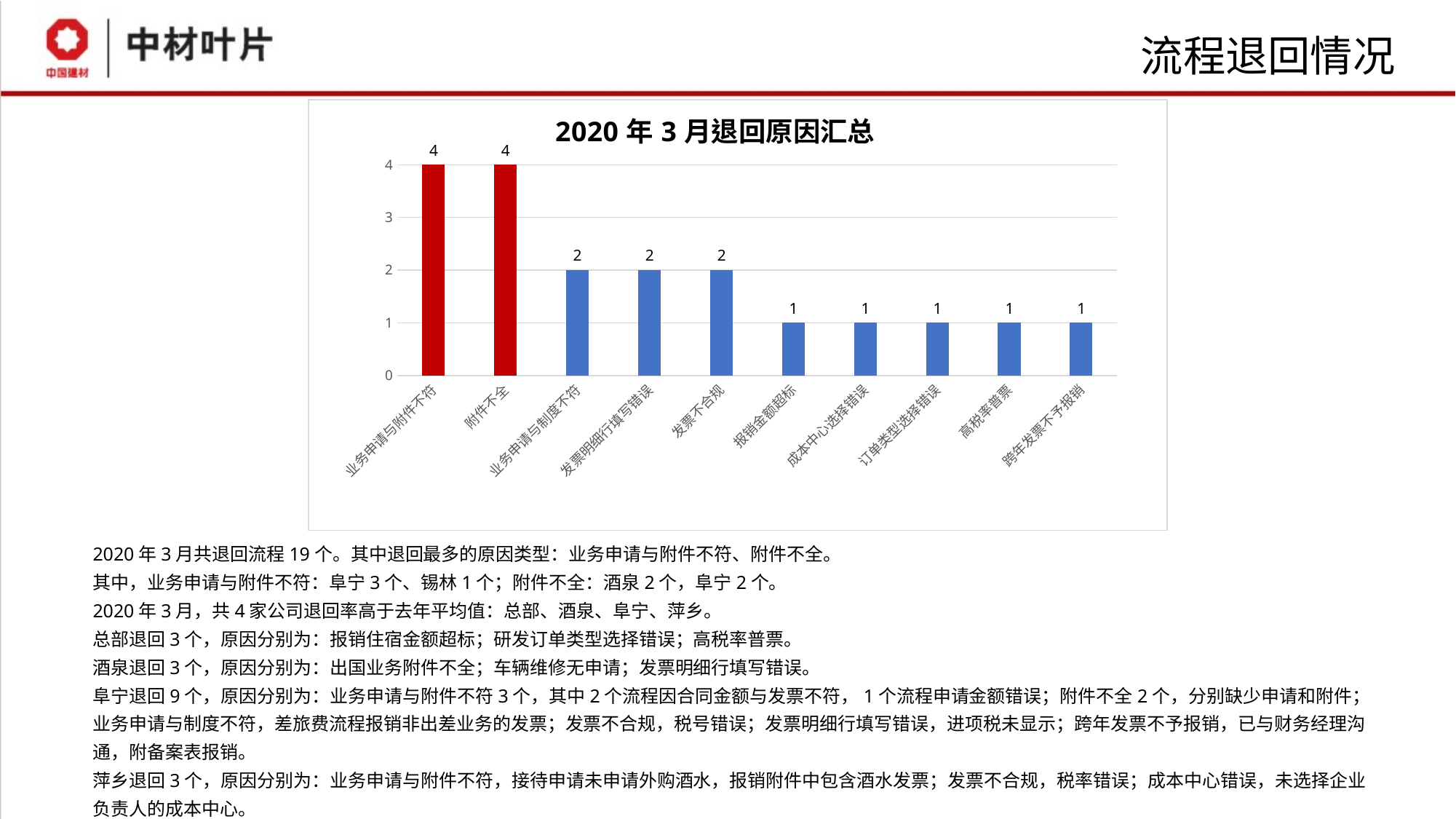
How many categories are shown in the chart? 10 What is the value for 发票不合规 in the chart? 2 What is the difference between the values for 附件不全 and 报销金额超标? 3 What is the difference between the values for 业务申请与附件不符 and 业务申请与制度不符? 2 Is the value for 跨年发票不予报销 greater or less than 2? less What is the title of the chart? 2020 年 3 月退回原因汇总 What kind of chart is shown on the slide? bar chart What is the value for 附件不全 in the chart? 4 What is the value for 业务申请与附件不符 in the chart? 4 What is the value for 发票明细行填写错误 in the chart? 2 Which is larger, the value for 业务申请与制度不符 or the value for 成本中心选择错误? 业务申请与制度不符 What is the value for 高税率普票 in the chart? 1